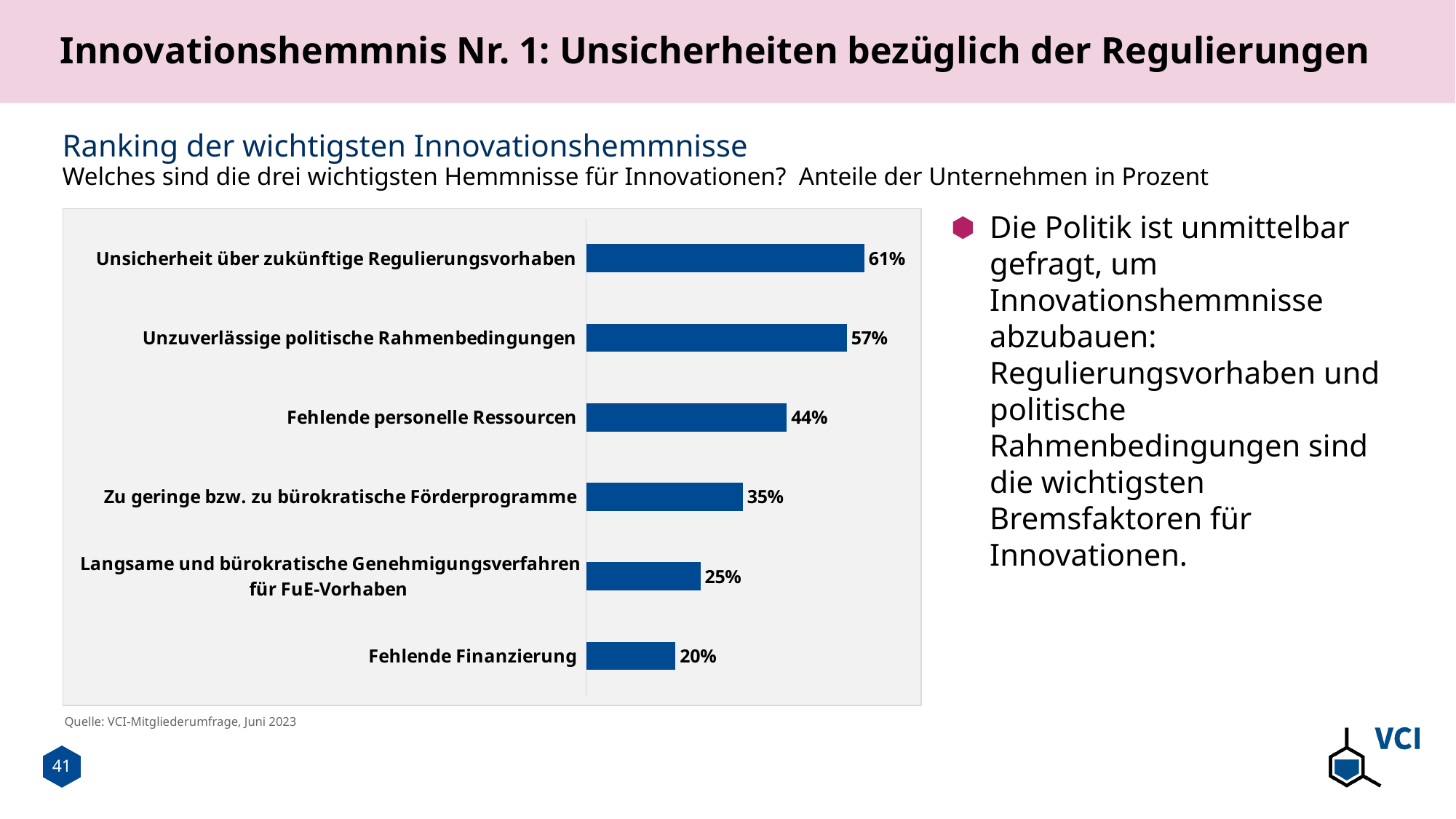
What is the title of the chart? Ranking der wichtigsten Innovationshemmnisse What is the difference between "Unsicherheit über zukünftige Regulierungsvorhaben" and "Unzuverlässige politische Rahmenbedingungen"? 4 percentage points What is the value for "Fehlende personelle Ressourcen"? 44% What kind of chart is shown on the slide? Bar chart What is the value for "Unsicherheit über zukünftige Regulierungsvorhaben"? 61% What is the difference between "Fehlende personelle Ressourcen" and "Fehlende Finanzierung"? 24 percentage points Which is larger: "Zu geringe bzw. zu bürokratische Förderprogramme" or "Langsame und bürokratische Genehmigungsverfahren für FuE-Vorhaben"? Zu geringe bzw. zu bürokratische Förderprogramme Which category has the highest value? Unsicherheit über zukünftige Regulierungsvorhaben What is the value for "Fehlende Finanzierung"? 20% What is the value for "Langsame und bürokratische Genehmigungsverfahren für FuE-Vorhaben"? 25% How many categories are shown in the chart? 6 Which category has the lowest value? Fehlende Finanzierung